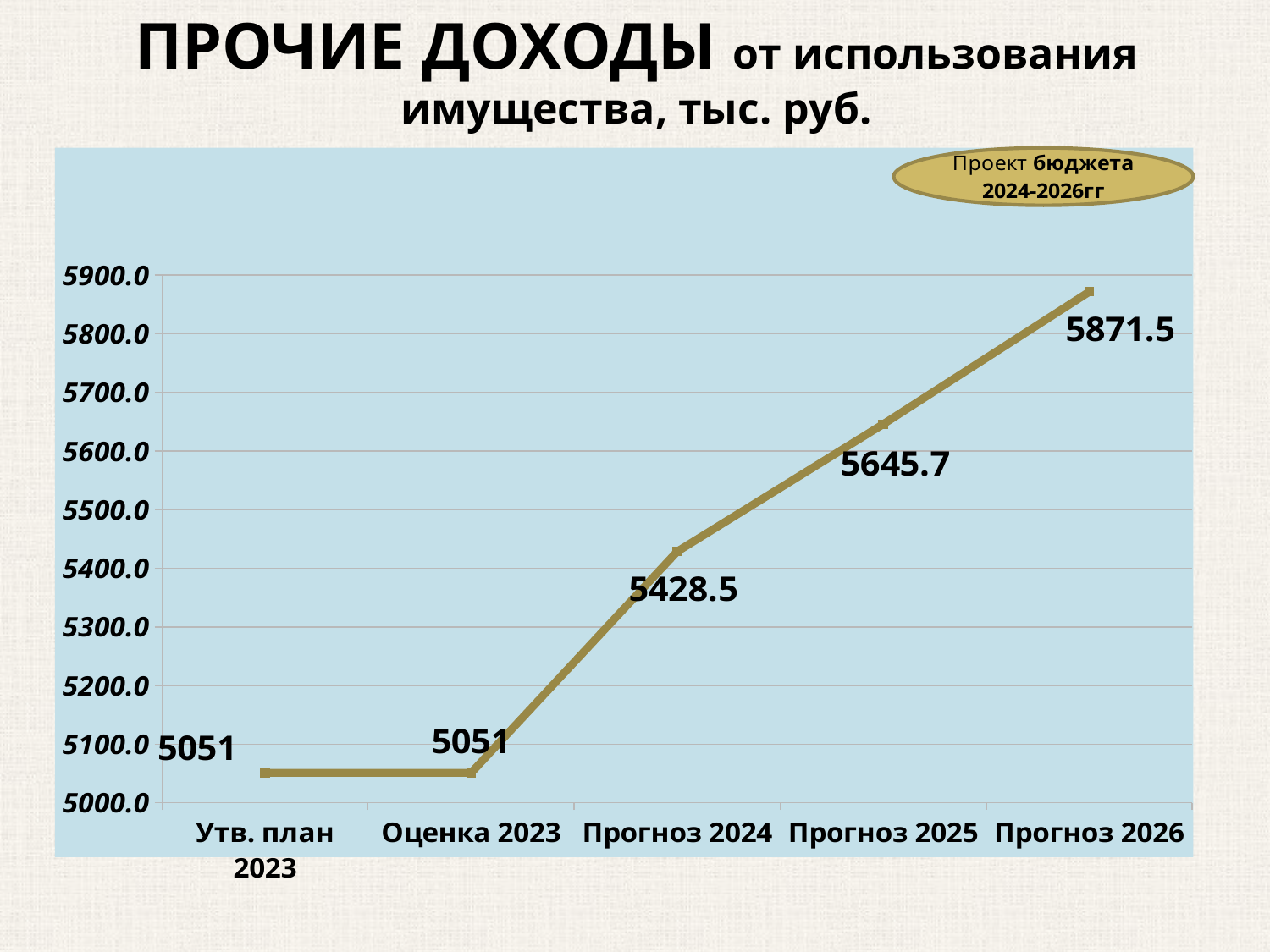
What is the value for Оценка 2023? 5051 What kind of chart is shown on the slide? line chart What is the difference between the values for Прогноз 2024 and Оценка 2023? 377.5 What is the value for Прогноз 2025? 5645.7 Is the value for Прогноз 2025 greater or less than 5600.0? greater What is the difference between the values for Прогноз 2026 and Прогноз 2025? 225.8 Do the values rise or fall from Оценка 2023 to Прогноз 2026? rise How many categories are shown on the x axis? 5 Which category has the highest value? Прогноз 2026 Which is larger, the value for Прогноз 2025 or the value for Прогноз 2024? Прогноз 2025 What is the value for Прогноз 2026? 5871.5 What is the value for Прогноз 2024? 5428.5